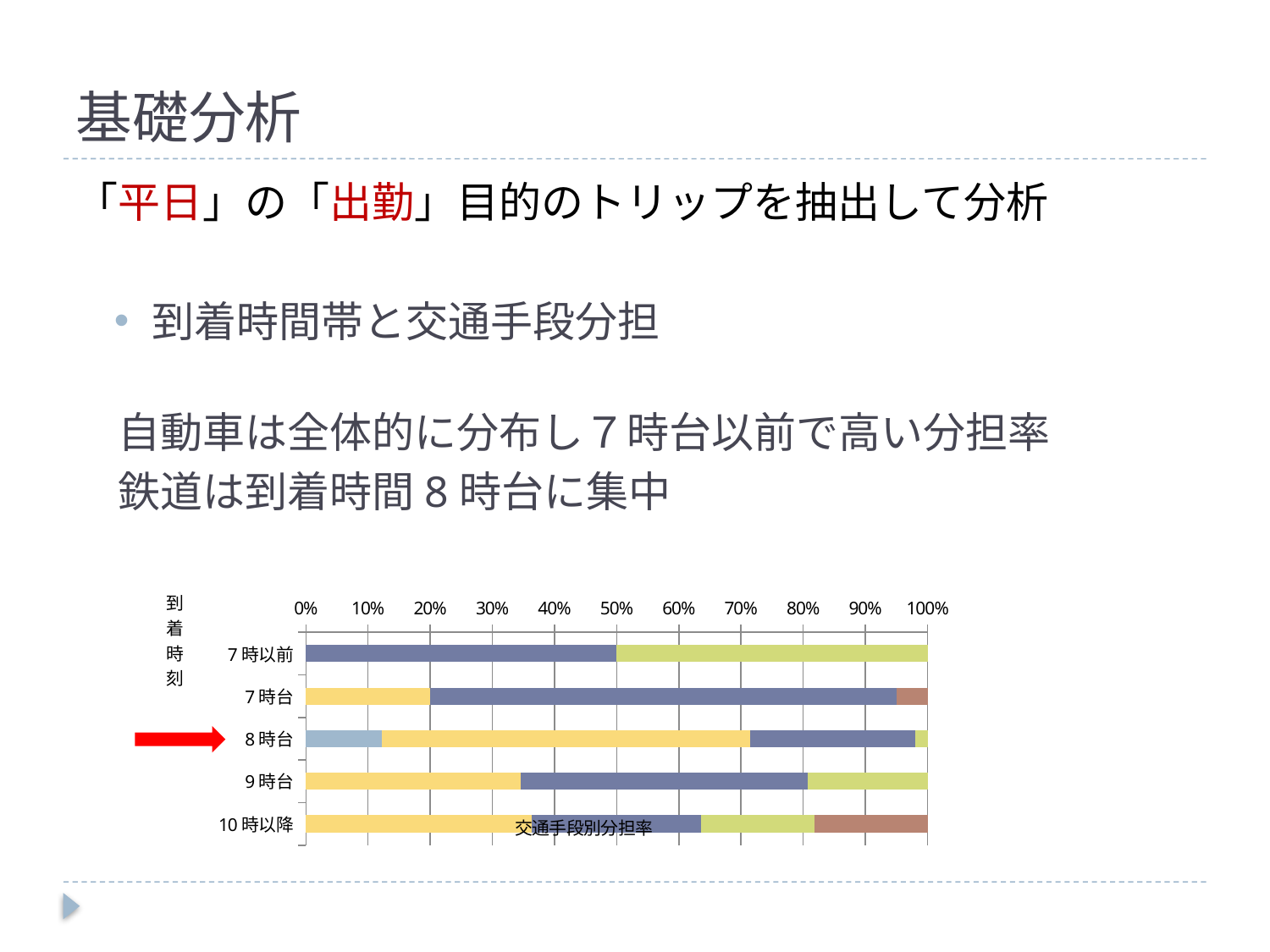
What kind of chart is shown on the slide? Stacked bar chart What is the title printed on the chart? 交通手段別分担率 Is the yellow segment of the 9時台 bar greater or less than 30%? greater Is the light blue segment at the start of the 8時台 bar greater or less than 20%? less What is the highest value shown on the chart's percentage axis? 100% How many arrival-time categories are plotted on the chart? 5 Is the dark blue segment of the 7時以前 bar greater or less than 40% of the bar? greater Which arrival-time category is marked with the red arrow? 8時台 Which is larger, the yellow segment of the 8時台 bar or the yellow segment of the 7時台 bar? 8時台 Which arrival-time category has the longest dark blue segment? 7時台 Which arrival-time category has the longest yellow segment? 8時台 How many coloured segments make up the bar for 7時以前? 2